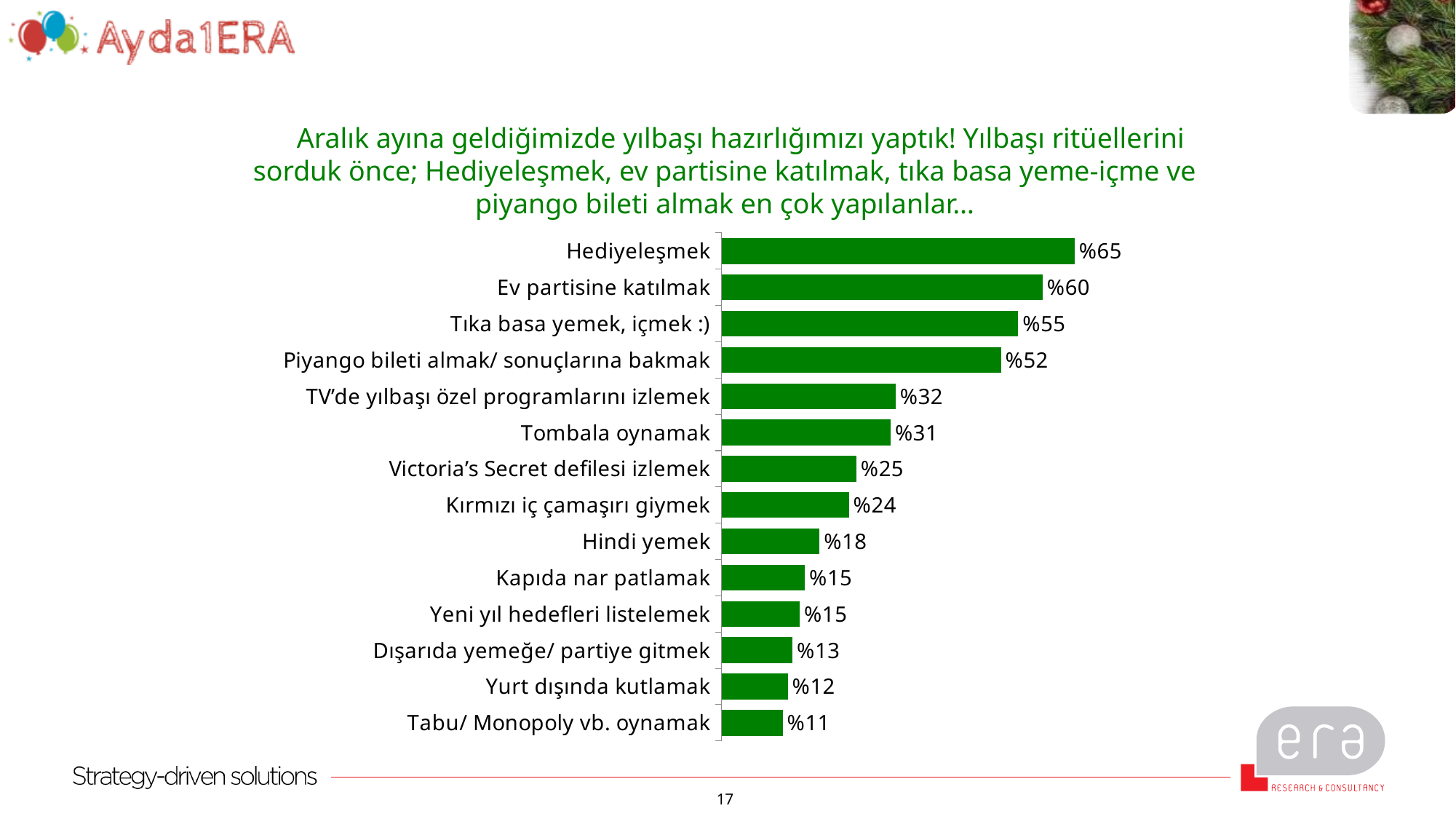
Which is larger, the value for Victoria's Secret defilesi izlemek or the value for Yurt dışında kutlamak? Victoria's Secret defilesi izlemek What is the value for Hediyeleşmek? %65 What is the value for Hindi yemek? %18 What kind of chart is shown on the slide? Bar chart What is the difference between the values for Hediyeleşmek and Ev partisine katılmak? 5 percentage points Which is larger, the value for Tıka basa yemek, içmek :) or the value for Piyango bileti almak/ sonuçlarına bakmak? Tıka basa yemek, içmek :) How many categories are shown in the chart? 14 What is the difference between the values for Tombala oynamak and Kırmızı iç çamaşırı giymek? 7 percentage points What is the value for TV'de yılbaşı özel programlarını izlemek? %32 What colour are the bars in the chart? Green Which category has the highest value? Hediyeleşmek Which category has the lowest value? Tabu/ Monopoly vb. oynamak